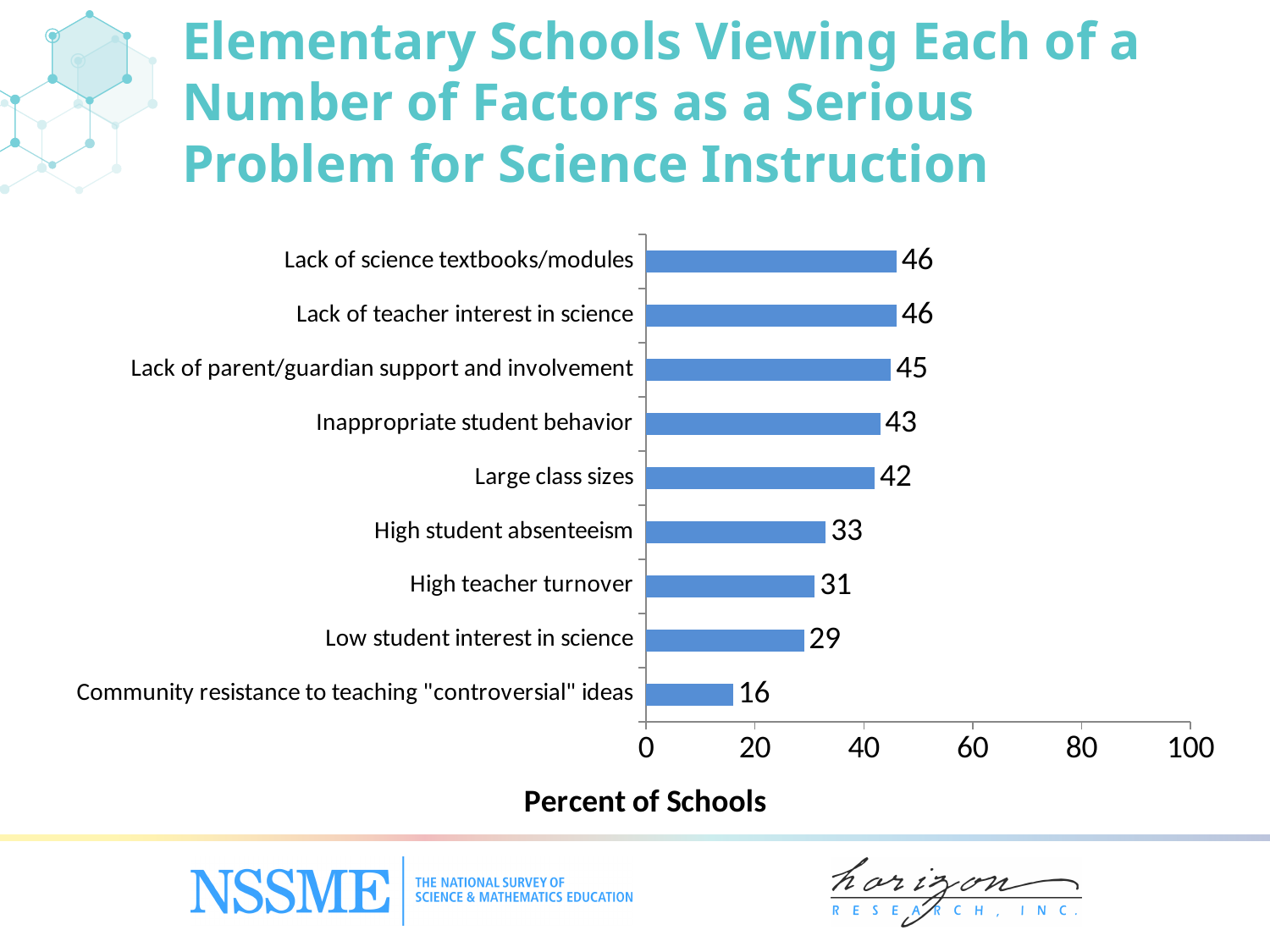
What is the difference between the values for lack of teacher interest in science and low student interest in science? 17 What kind of chart is shown on the slide? Bar chart How many factors are shown in the chart? 9 What is the value for inappropriate student behavior? 43 What is the value for community resistance to teaching "controversial" ideas? 16 What is the difference between the values for large class sizes and high student absenteeism? 9 Which is larger, the value for high student absenteeism or the value for low student interest in science? High student absenteeism What is the value for high teacher turnover? 31 What is the label of the horizontal axis? Percent of Schools Which factor has the lowest percent of schools viewing it as a serious problem? Community resistance to teaching "controversial" ideas Is the value for lack of parent/guardian support and involvement greater or less than 40? greater What percent of schools view lack of science textbooks/modules as a serious problem? 46